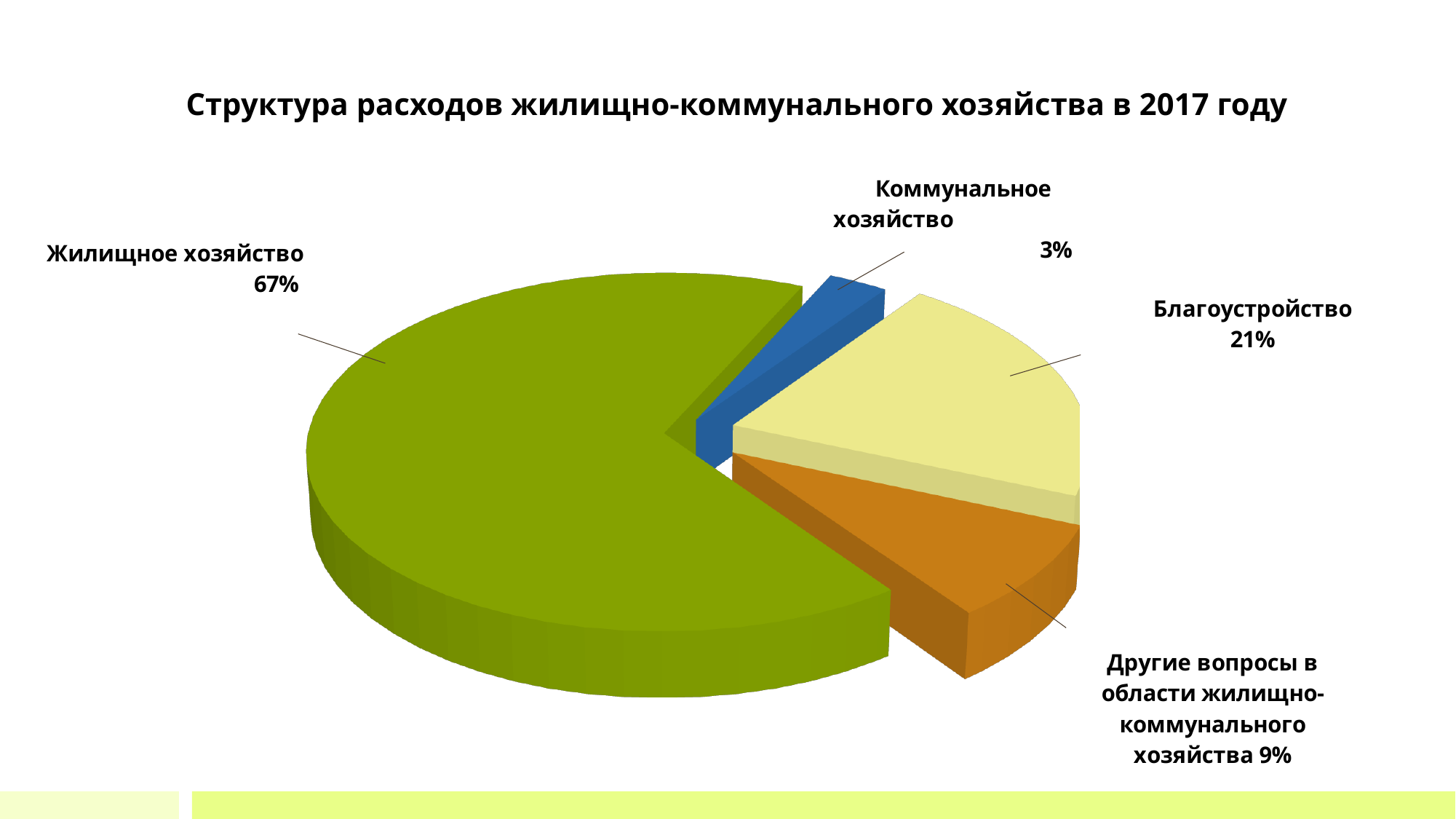
What share of the pie does Благоустройство have? 21% What is the difference in percentage points between Жилищное хозяйство and Благоустройство? 46 Which category has the largest share of the pie? Жилищное хозяйство What is the title of the chart? Структура расходов жилищно-коммунального хозяйства в 2017 году Which is larger, the share for Благоустройство or the share for Другие вопросы в области жилищно-коммунального хозяйства? Благоустройство What is the difference in percentage points between Благоустройство and Другие вопросы в области жилищно-коммунального хозяйства? 12 What kind of chart is shown on the slide? Pie chart How many slices does the pie chart have? 4 What share of the pie does Коммунальное хозяйство have? 3% What share of the pie does Другие вопросы в области жилищно-коммунального хозяйства have? 9% Which category has the smallest share of the pie? Коммунальное хозяйство